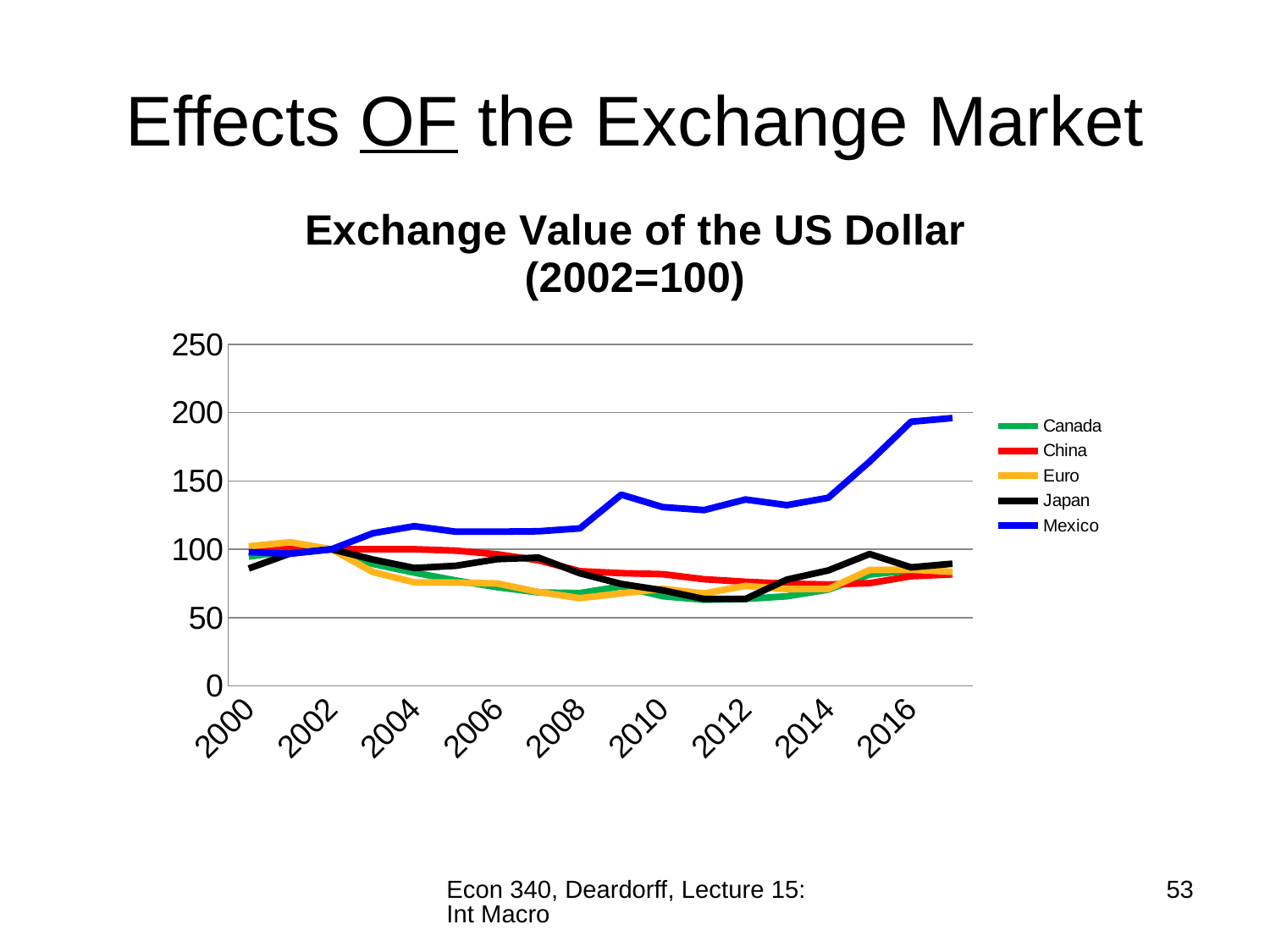
Is the value for Mexico in 2016 greater or less than 150? greater Which colour is used for the Mexico line? blue What is the value of every series in the base year 2002? 100 Is the value for Mexico in 2010 greater or less than 100? greater Is the value for Euro in 2004 greater or less than 100? less What is the title of the chart? Exchange Value of the US Dollar (2002=100) How many series does the legend list? 5 Which is larger in 2014, the value for Mexico or the value for Japan? Mexico What kind of chart is shown on the slide? line chart Which series has the highest value in 2016? Mexico Does the Mexico line generally rise or fall from 2002 to 2016? rise